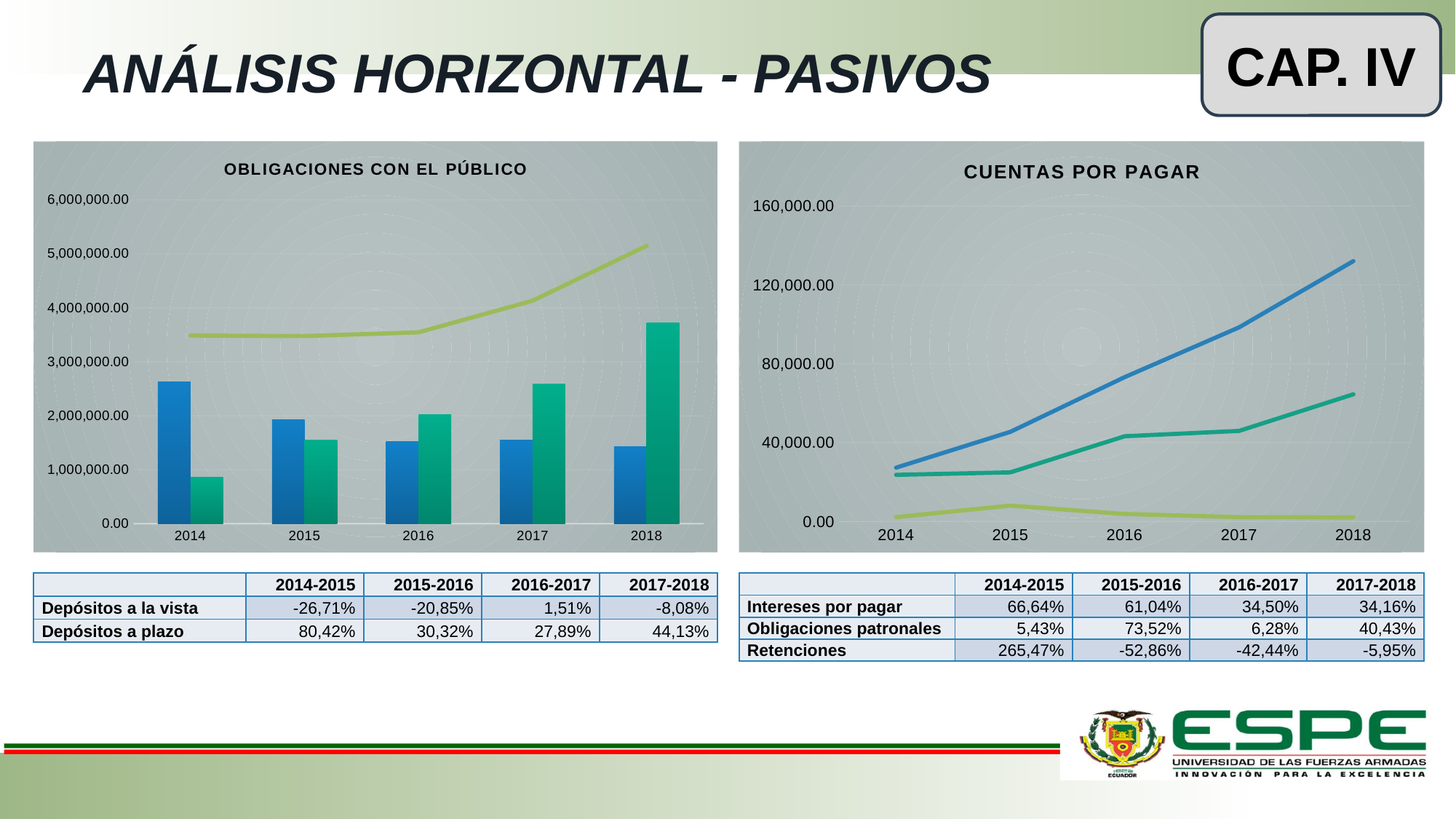
In the OBLIGACIONES CON EL PÚBLICO chart, do the green bars rise or fall from 2014 to 2018? rise In the OBLIGACIONES CON EL PÚBLICO chart, how many years are shown on the x axis? 5 In the OBLIGACIONES CON EL PÚBLICO chart, is the green bar for 2018 greater or less than 3,000,000.00? greater In the OBLIGACIONES CON EL PÚBLICO chart, for 2014, which bar is taller, the blue one or the green one? the blue one What kind of chart is the OBLIGACIONES CON EL PÚBLICO chart on the left? combination bar and line chart In the OBLIGACIONES CON EL PÚBLICO chart, is the blue bar for 2018 greater or less than 2,000,000.00? less In the OBLIGACIONES CON EL PÚBLICO chart, which year has the tallest green bar? 2018 What kind of chart is the CUENTAS POR PAGAR chart on the right? line chart In the CUENTAS POR PAGAR chart, is the value of the blue line in 2018 greater or less than 120,000.00? greater In the CUENTAS POR PAGAR chart, does the blue line rise or fall from 2014 to 2018? rise In the OBLIGACIONES CON EL PÚBLICO chart, which year has the tallest blue bar? 2014 In the CUENTAS POR PAGAR chart, how many lines are plotted? 3